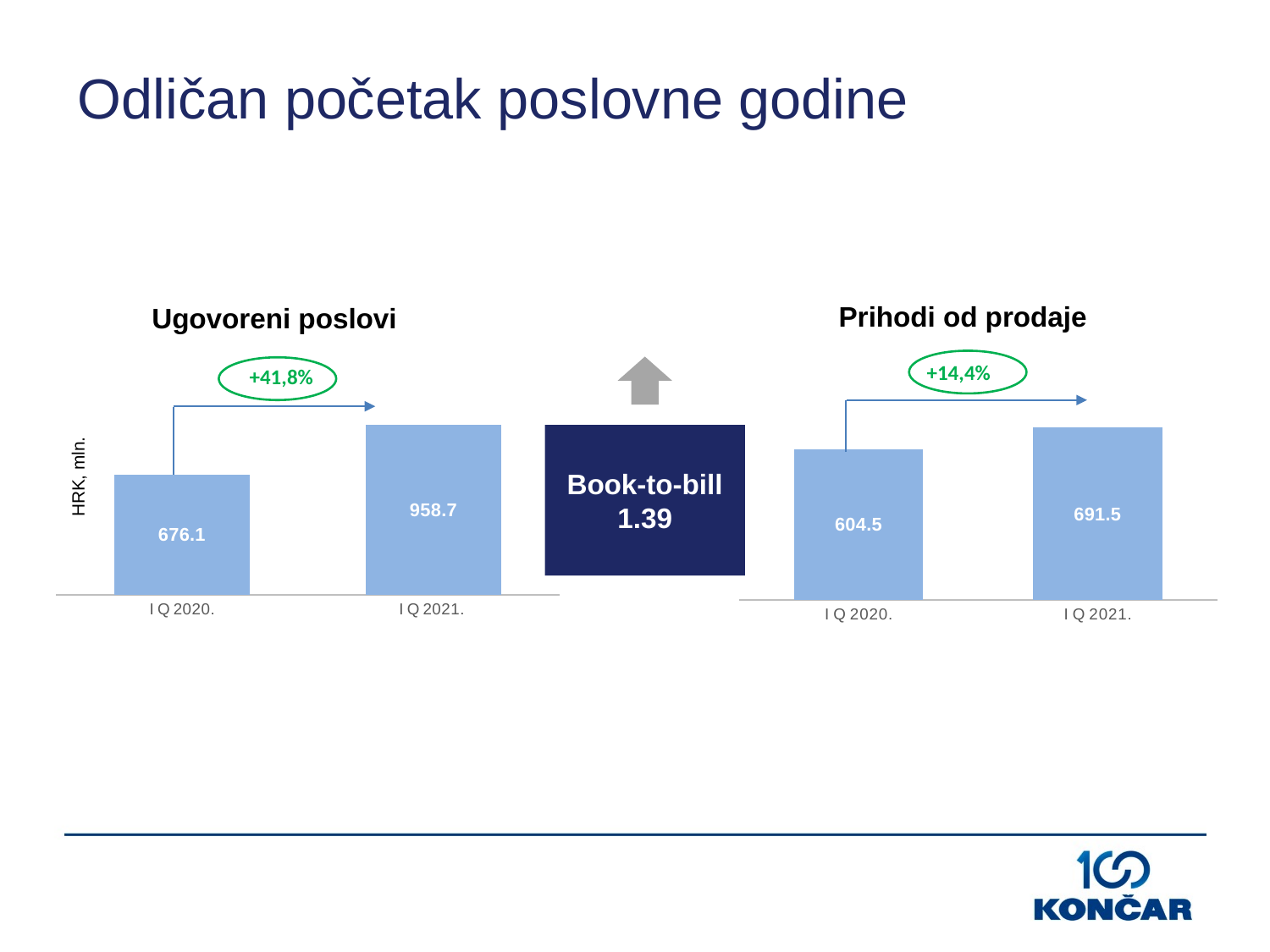
In the 'Prihodi od prodaje' chart, what is the value for I Q 2021.? 691.5 In the 'Ugovoreni poslovi' chart, what is the difference between the I Q 2021. and I Q 2020. values? 282.6 In the 'Ugovoreni poslovi' chart, what is the value for I Q 2021.? 958.7 In the 'Prihodi od prodaje' chart, what is the value for I Q 2020.? 604.5 What unit is shown on the vertical axis label of the 'Ugovoreni poslovi' chart? HRK, mln. Is the I Q 2021. value in the 'Ugovoreni poslovi' chart larger or smaller than the I Q 2021. value in the 'Prihodi od prodaje' chart? larger In the 'Ugovoreni poslovi' chart, which period has the higher value? I Q 2021. What type of chart is the 'Ugovoreni poslovi' chart? bar chart In the 'Prihodi od prodaje' chart, which period has the lower value? I Q 2020. In the 'Ugovoreni poslovi' chart, what is the value for I Q 2020.? 676.1 In the 'Prihodi od prodaje' chart, what is the difference between the I Q 2021. and I Q 2020. values? 87.0 How many bars are shown in the 'Prihodi od prodaje' chart? 2